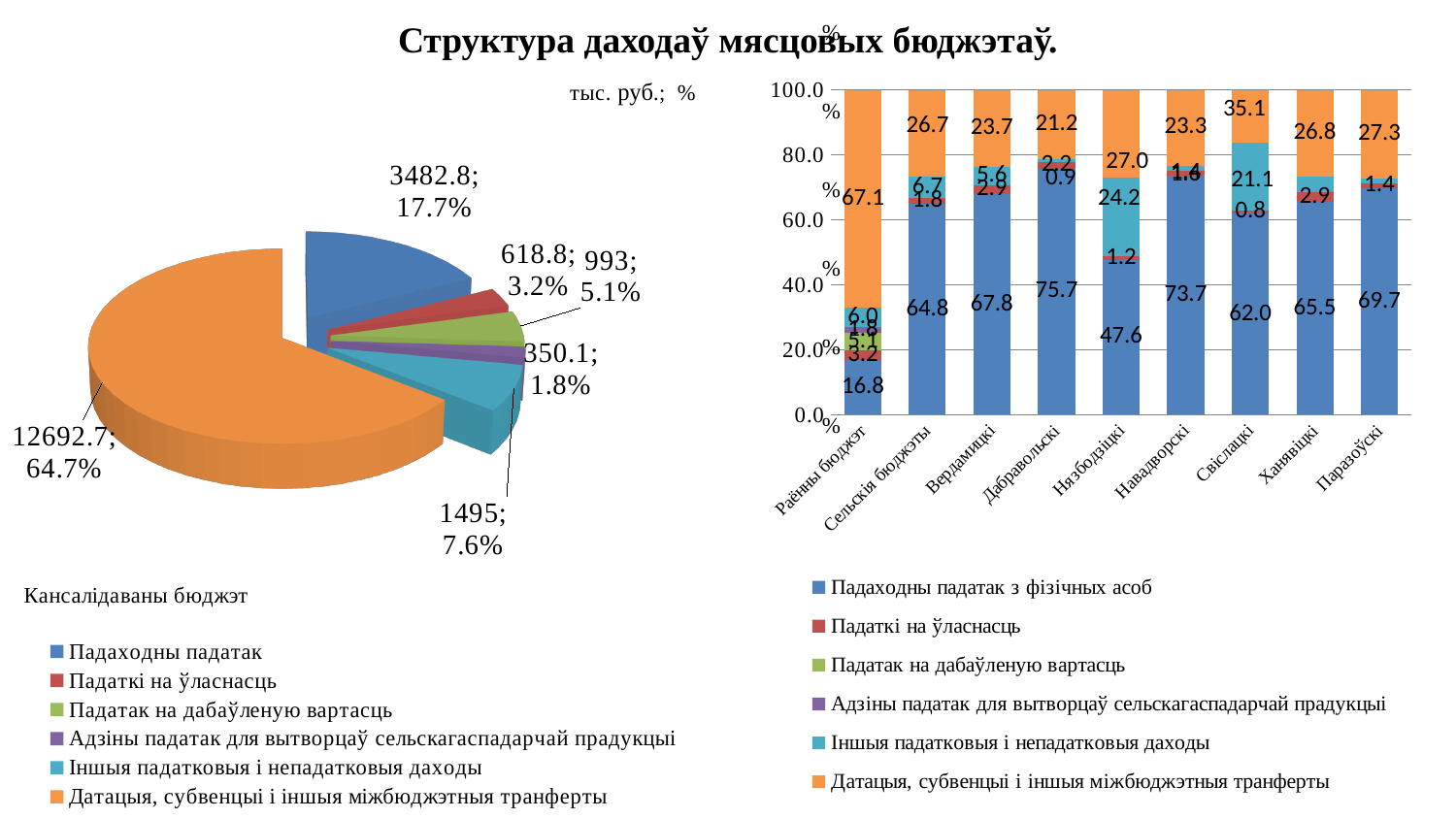
In the pie chart (Кансалідаваны бюджэт), what value is shown for Падаходны падатак? 3482.8; 17.7% In the stacked bar chart on the right, which has the larger value for Падаходны падатак з фізічных асоб: Сельскія бюджэты or Вердамицкі? Вердамицкі In the pie chart (Кансалідаваны бюджэт), what is the difference between the values for Падаходны падатак (3482.8) and Іншыя падатковыя і непадатковыя даходы (1495)? 1987.8 In the stacked bar chart on the right, how many categories are shown on the x axis? 9 What kind of chart is the chart on the right of the slide? Stacked bar chart In the pie chart (Кансалідаваны бюджэт), which category has the smallest slice? Адзіны падатак для вытворцаў сельскагаспадарчай прадукцыі In the stacked bar chart on the right, what is the value of Датацыя, субвенцыі і іншыя міжбюджэтныя трансферты for Нязбодзіцкі? 27.0 In the pie chart (Кансалідаваны бюджэт), how many slices are there? 6 In the stacked bar chart on the right, which category has the lowest value for Падаходны падатак з фізічных асоб? Нязбодзіцкі In the stacked bar chart on the right, how many series does the legend list? 6 In the pie chart (Кансалідаваны бюджэт), what share does Датацыя, субвенцыі і іншыя міжбюджэтныя трансферты have? 64.7% In the stacked bar chart on the right, what is the value of Падаходны падатак з фізічных асоб for Дабравольскі? 75.7